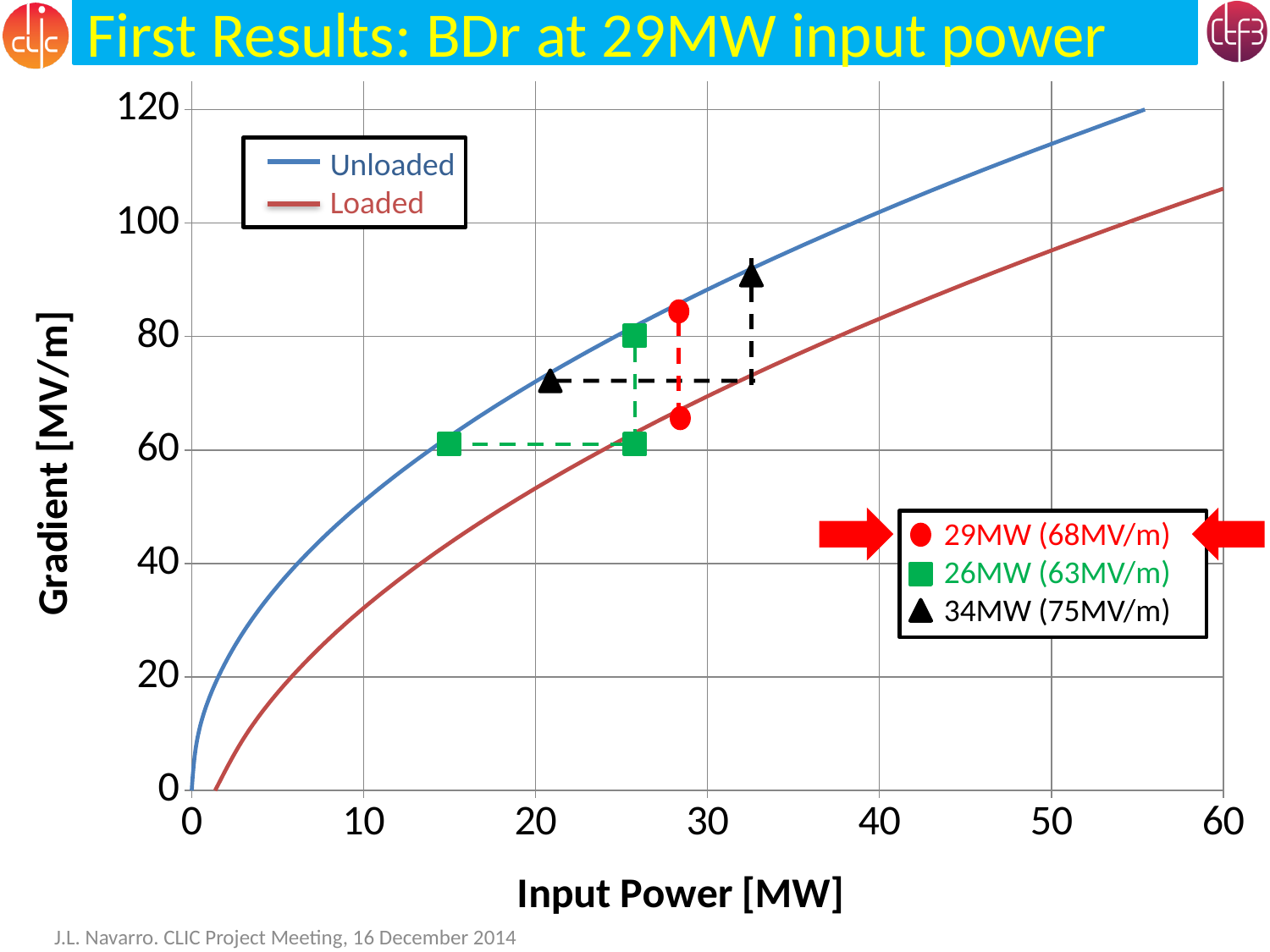
Is the Loaded gradient at 40 MW input power greater or less than 100 MV/m? less What kind of chart is shown on the slide? line chart What gradient is given for the 29MW point in the marker legend? 68MV/m What is the difference in gradient between the 34MW point and the 26MW point listed in the marker legend? 12MV/m Which curve is higher at any given input power, Unloaded or Loaded? Unloaded What gradient is given for the 26MW point in the marker legend? 63MV/m How many series does the top-left legend list? 2 Is the Unloaded gradient at 50 MW input power greater or less than 100 MV/m? greater Which of the three marker points in the lower legend has the lowest gradient? 26MW (63MV/m) Does the gradient rise or fall as input power increases along the x axis? rise What are the two series named in the top-left legend? Unloaded and Loaded What gradient is given for the 34MW point in the marker legend? 75MV/m